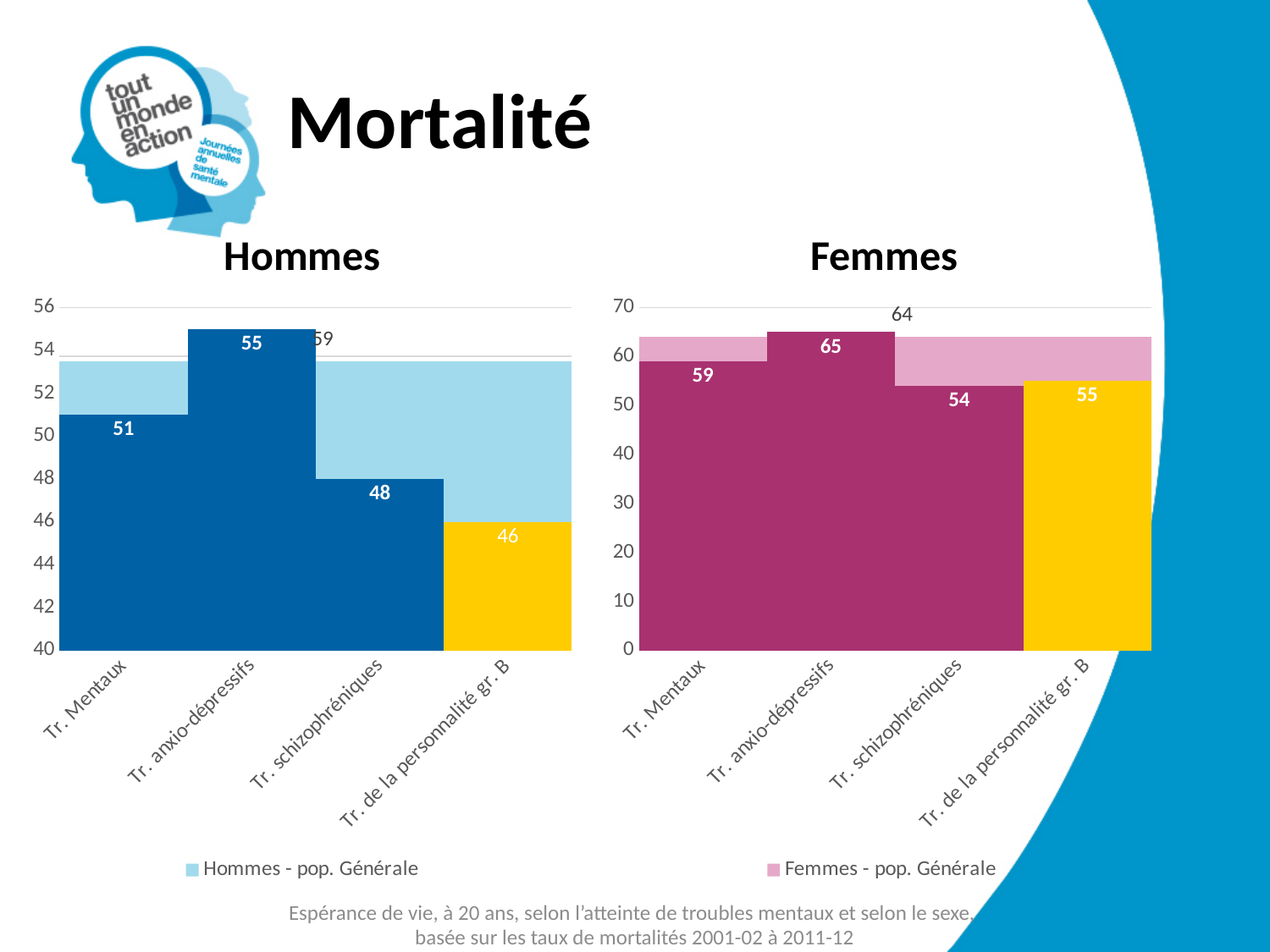
In the Hommes chart, what is the value for Tr. Mentaux? 51 In the Hommes chart, which category has the lowest value? Tr. de la personnalité gr. B In the Femmes chart, what is the value for Tr. anxio-dépressifs? 65 What kind of chart is the Hommes chart? bar chart In the Femmes chart, which is larger: the value for Tr. schizophréniques or the value for Tr. de la personnalité gr. B? Tr. de la personnalité gr. B In the Femmes chart, what is the difference between the values for Tr. anxio-dépressifs and Tr. schizophréniques? 11 In the Femmes chart, which category has the highest value? Tr. anxio-dépressifs In the Hommes chart, what is the difference between the values for Tr. anxio-dépressifs and Tr. de la personnalité gr. B? 9 In the Femmes chart, what is the value for Tr. Mentaux? 59 How many categories are shown on the x axis of the Femmes chart? 4 In the Hommes chart, what is the value for Tr. schizophréniques? 48 In the Hommes chart, which category has the highest value? Tr. anxio-dépressifs